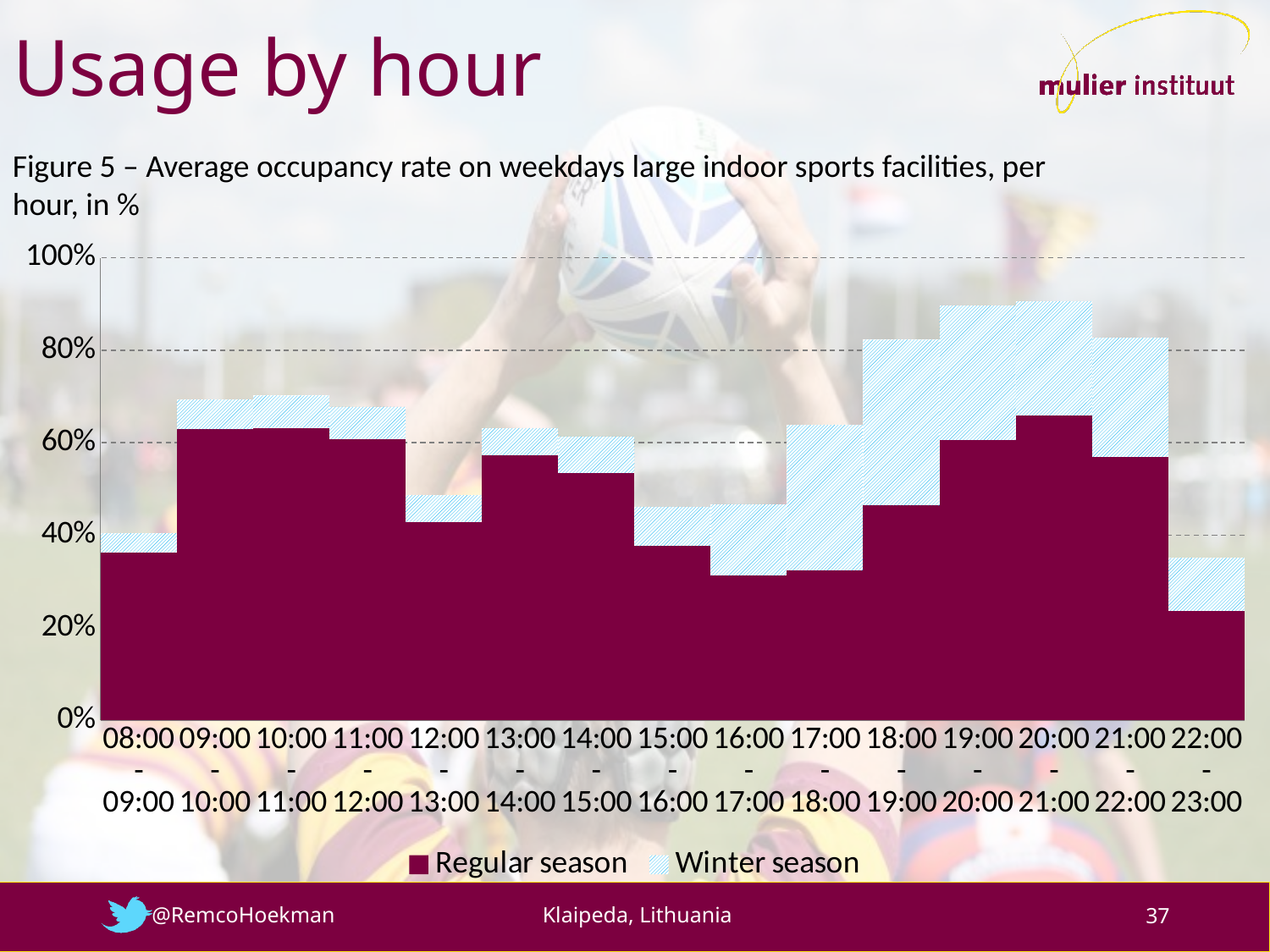
For 18:00 - 19:00, which series has the higher occupancy rate, Regular season or Winter season? Regular season What kind of chart is shown on the slide? bar chart Is the Regular season value for 22:00 - 23:00 greater or less than 20%? greater How many series does the legend list? 2 Which time slot has the lowest Regular season occupancy rate? 22:00 - 23:00 How many hourly time slots are shown on the x axis? 15 Which is larger: the Regular season value for 09:00 - 10:00 or for 22:00 - 23:00? 09:00 - 10:00 What are the two series named in the legend? Regular season and Winter season Is the Regular season value for 08:00 - 09:00 greater or less than 40%? less Do the Regular season values rise or fall from 18:00 - 19:00 to 20:00 - 21:00? rise